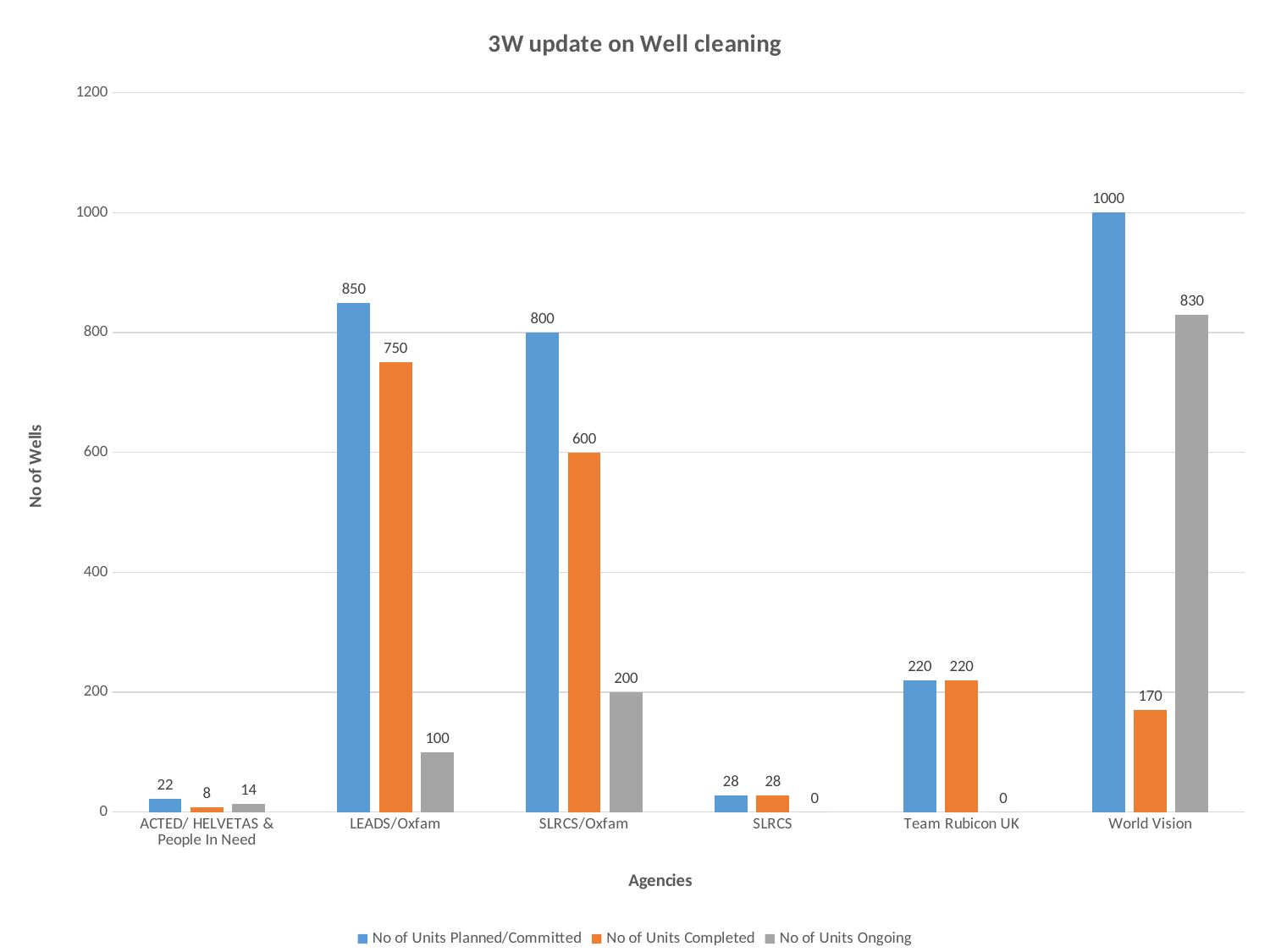
What kind of chart is shown? Bar chart How many agencies are shown on the x axis? 6 What is the title of the chart? 3W update on Well cleaning What is the number of units planned/committed for World Vision? 1000 What is the number of units ongoing for SLRCS/Oxfam? 200 What is the label of the y axis? No of Wells What is the number of units completed for LEADS/Oxfam? 750 Which is larger for World Vision: the number of units ongoing or the number of units completed? No of Units Ongoing Which agency has the highest number of units planned/committed? World Vision Which agency has the lowest number of units completed? ACTED/ HELVETAS & People In Need How many series does the legend list? 3 What is the difference between units planned/committed and units completed for SLRCS/Oxfam? 200